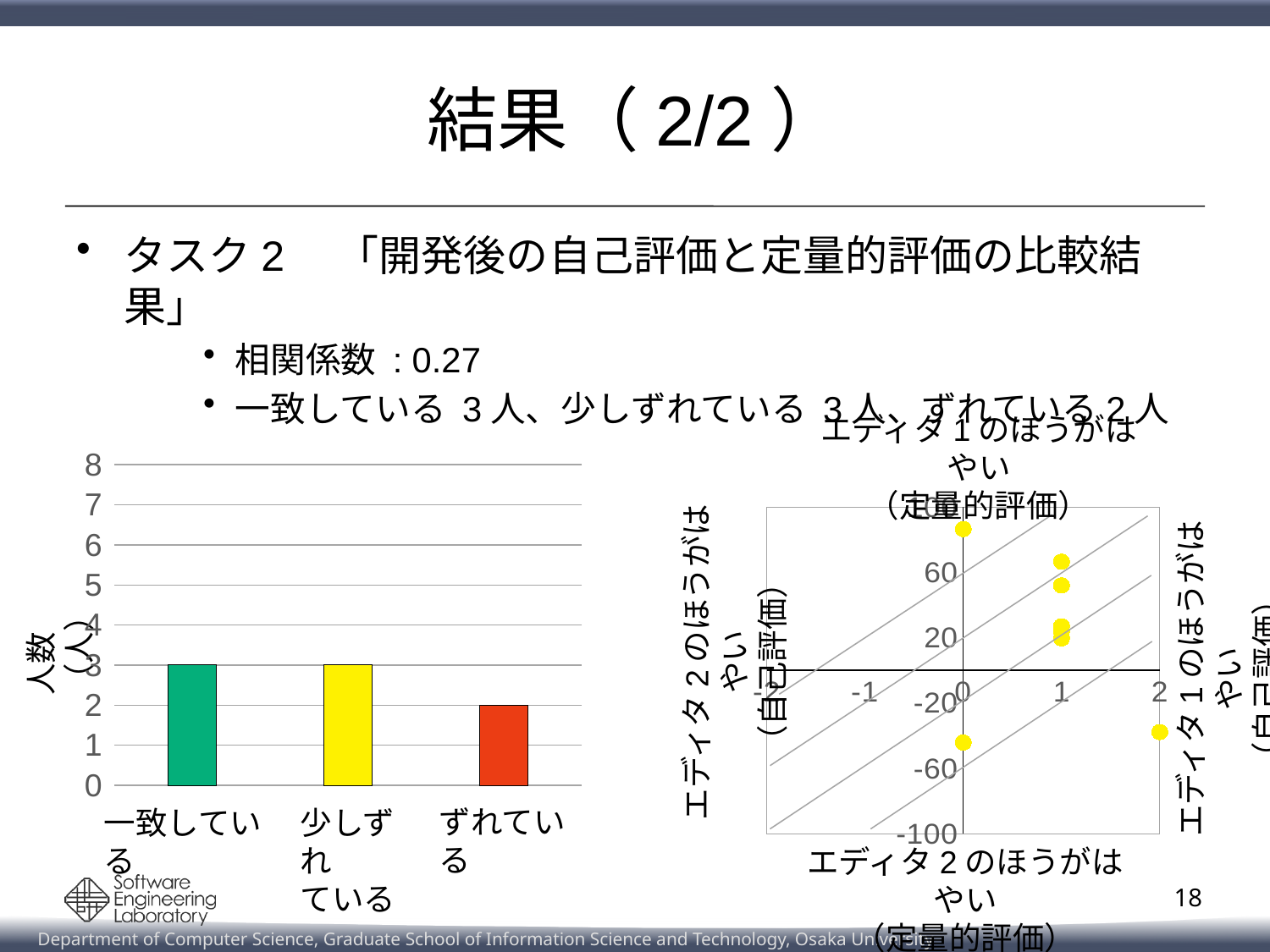
How many categories are shown in the bar chart on the left? 3 In the scatter chart on the right, is the y value of the highest point greater or less than 60? greater In the bar chart on the left, which category has the lowest value? ずれている In the bar chart on the left, what is the difference between the values for 一致している and ずれている? 1 In the bar chart on the left, what is the value for ずれている? 2 In the bar chart on the left, is the value for 一致している greater or less than 5? less What kind of chart is the chart on the left? bar chart In the bar chart on the left, what is the value for 一致している? 3 In the bar chart on the left, which is larger, the value for 少しずれている or the value for ずれている? 少しずれている What kind of chart is the chart on the right? scatter chart In the bar chart on the left, what colour is the bar for ずれている? red